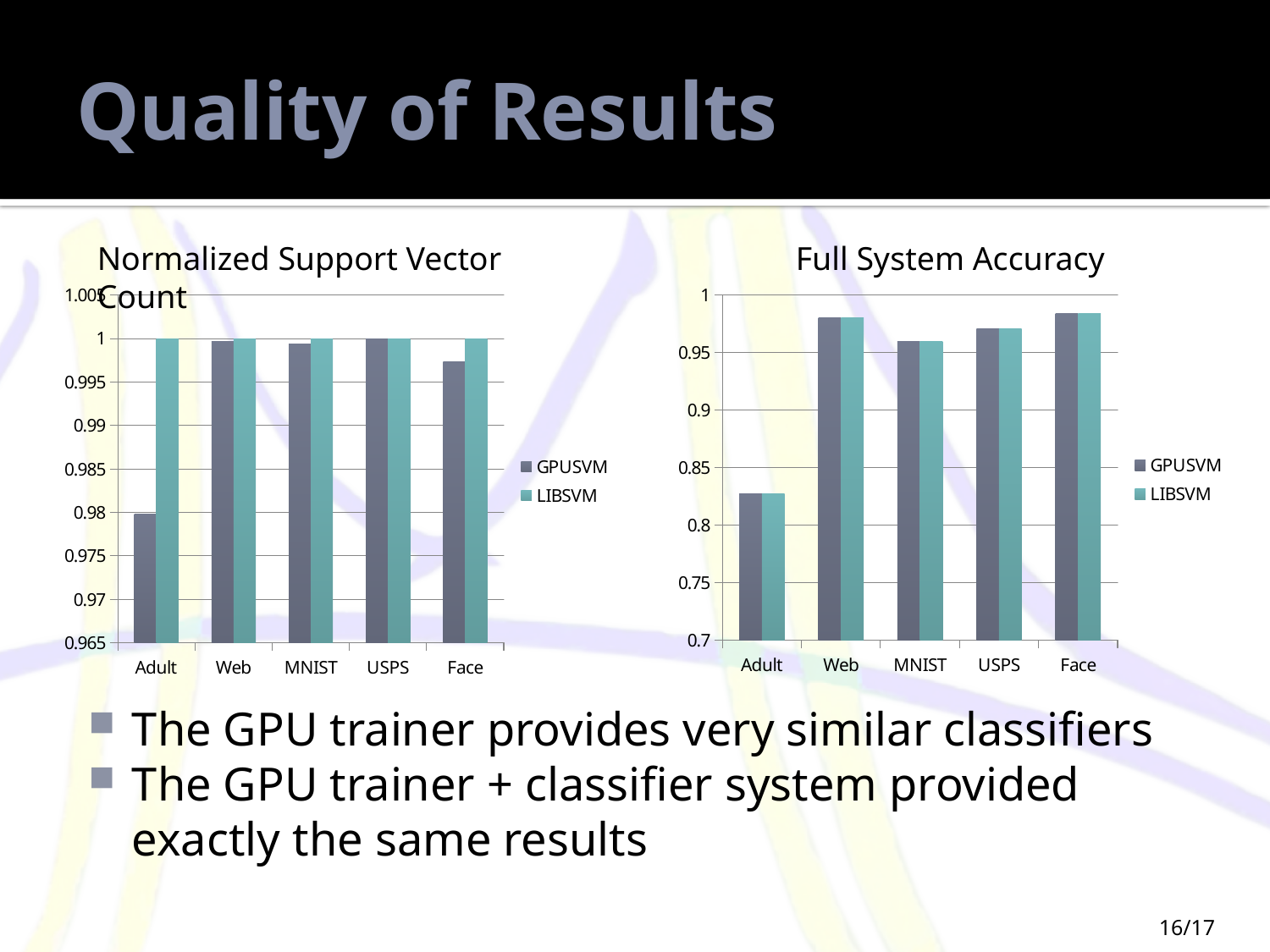
In the Normalized Support Vector Count chart, which is larger for Adult, the GPUSVM value or the LIBSVM value? LIBSVM How many series does the legend of the Full System Accuracy chart list? 2 In the Full System Accuracy chart, is the value for Adult greater or less than 0.85? less In the Full System Accuracy chart, which category has the lowest accuracy? Adult What are the two series named in the legend of the Normalized Support Vector Count chart? GPUSVM and LIBSVM In the Full System Accuracy chart, is the GPUSVM value for Web greater or less than 0.95? greater In the Normalized Support Vector Count chart, which category has the lowest GPUSVM value? Adult In the Normalized Support Vector Count chart, what is the LIBSVM value for Web? 1 In the Normalized Support Vector Count chart, is the GPUSVM value for Adult greater or less than 0.985? less What kind of chart is the Normalized Support Vector Count chart? bar chart In the Full System Accuracy chart, which is larger, the GPUSVM value for Web or the GPUSVM value for MNIST? Web How many categories are shown on the x axis of the Full System Accuracy chart? 5